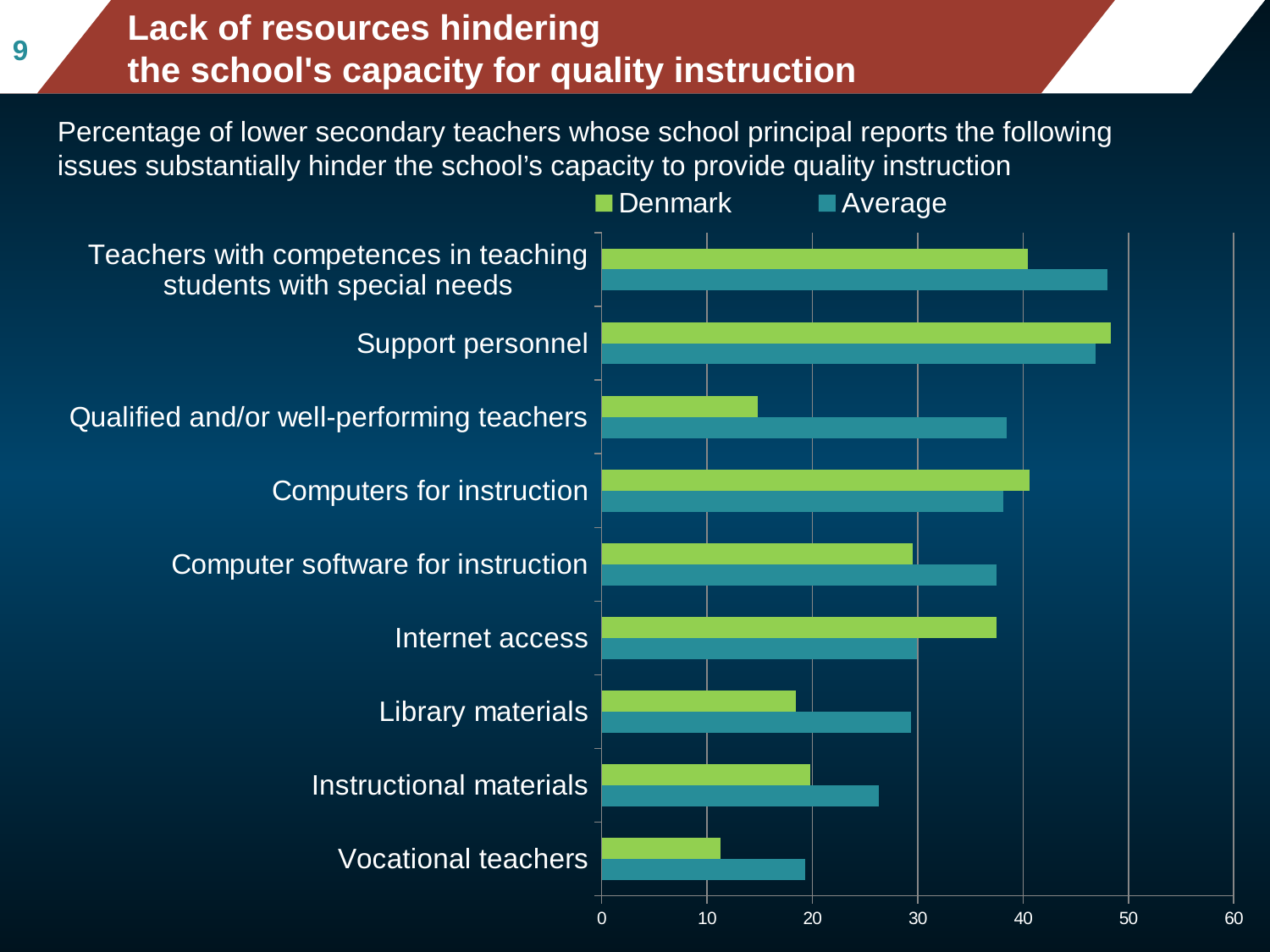
Is the Average value for Qualified and/or well-performing teachers greater or less than 30? greater How many series does the legend list? 2 What kind of chart is shown on the slide? Bar chart Is the Denmark value for Qualified and/or well-performing teachers greater or less than 20? less Which category has the highest value for Denmark? Support personnel Which category has the lowest value for Average? Vocational teachers For Internet access, which is larger: Denmark or Average? Denmark For Qualified and/or well-performing teachers, which is larger: Denmark or Average? Average Which series is shown in green in the legend? Denmark How many resource categories are plotted on the chart? 9 Which category has the lowest value for Denmark? Vocational teachers Is the Denmark value for Internet access greater or less than 30? greater